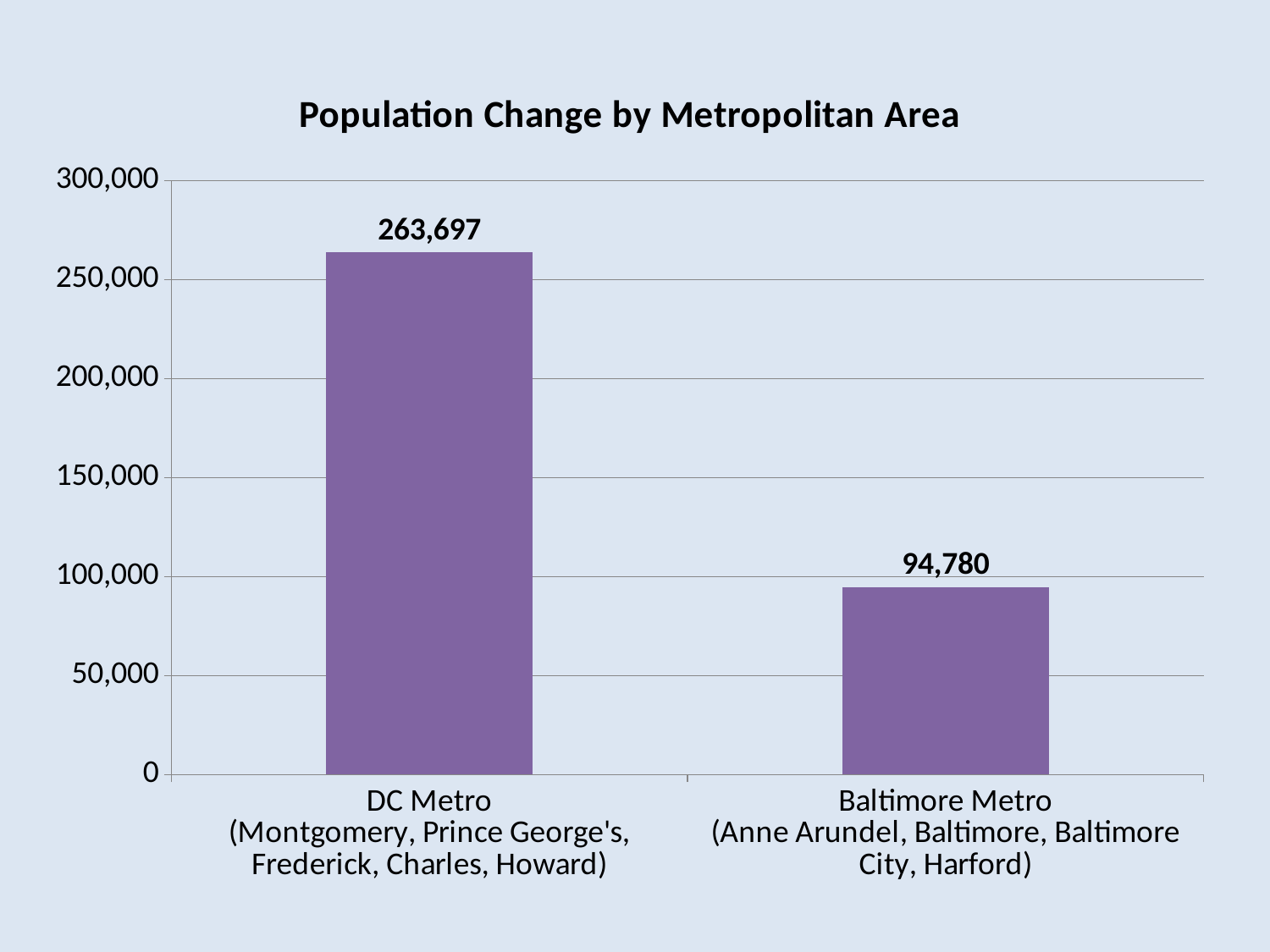
How many metropolitan areas are shown in the chart? 2 What is the title of the chart? Population Change by Metropolitan Area What kind of chart is shown on the slide? bar chart Which counties are listed under the Baltimore Metro category? Anne Arundel, Baltimore, Baltimore City, Harford Is the population change for DC Metro greater or less than 250,000? greater What is the population change for DC Metro? 263,697 What is the difference in population change between DC Metro and Baltimore Metro? 168,917 What is the population change for Baltimore Metro? 94,780 Which metropolitan area has the lowest population change? Baltimore Metro Which has a larger population change, DC Metro or Baltimore Metro? DC Metro Which metropolitan area has the highest population change? DC Metro Is the population change for Baltimore Metro greater or less than 100,000? less